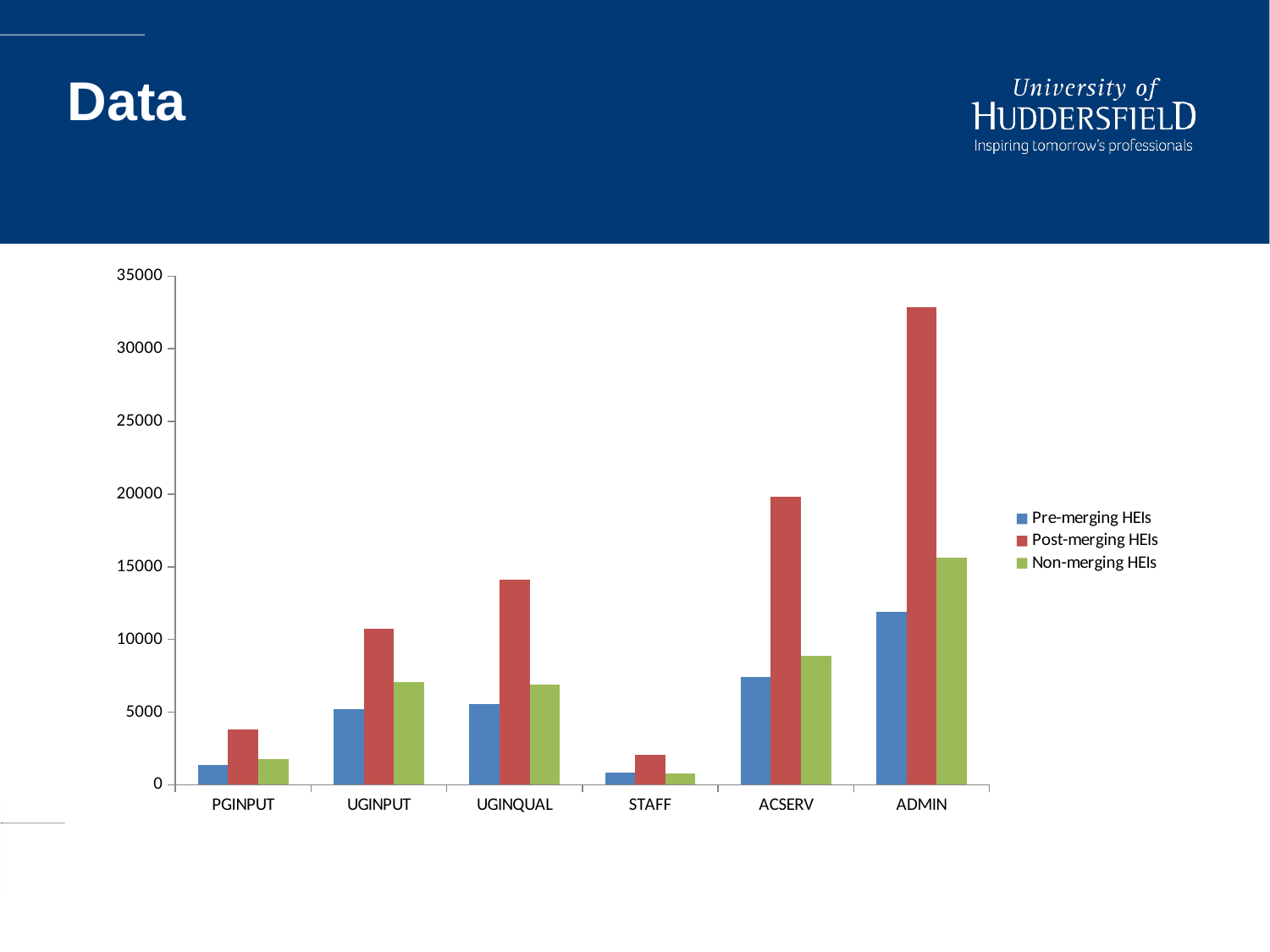
Is the value for Post-merging HEIs in ACSERV greater or less than 15000? greater Is the value for Non-merging HEIs in ADMIN greater or less than 10000? greater Is the value for Pre-merging HEIs in ADMIN greater or less than 10000? greater In UGINPUT, which is larger: Post-merging HEIs or Non-merging HEIs? Post-merging HEIs How many series does the chart's legend list? 3 What kind of chart is shown on the slide? bar chart Which category has the highest value for Post-merging HEIs? ADMIN In ACSERV, which is larger: Pre-merging HEIs or Non-merging HEIs? Non-merging HEIs What are the three series listed in the chart's legend? Pre-merging HEIs, Post-merging HEIs, Non-merging HEIs How many categories are shown on the x axis of the chart? 6 Which category has the lowest value for Post-merging HEIs? STAFF